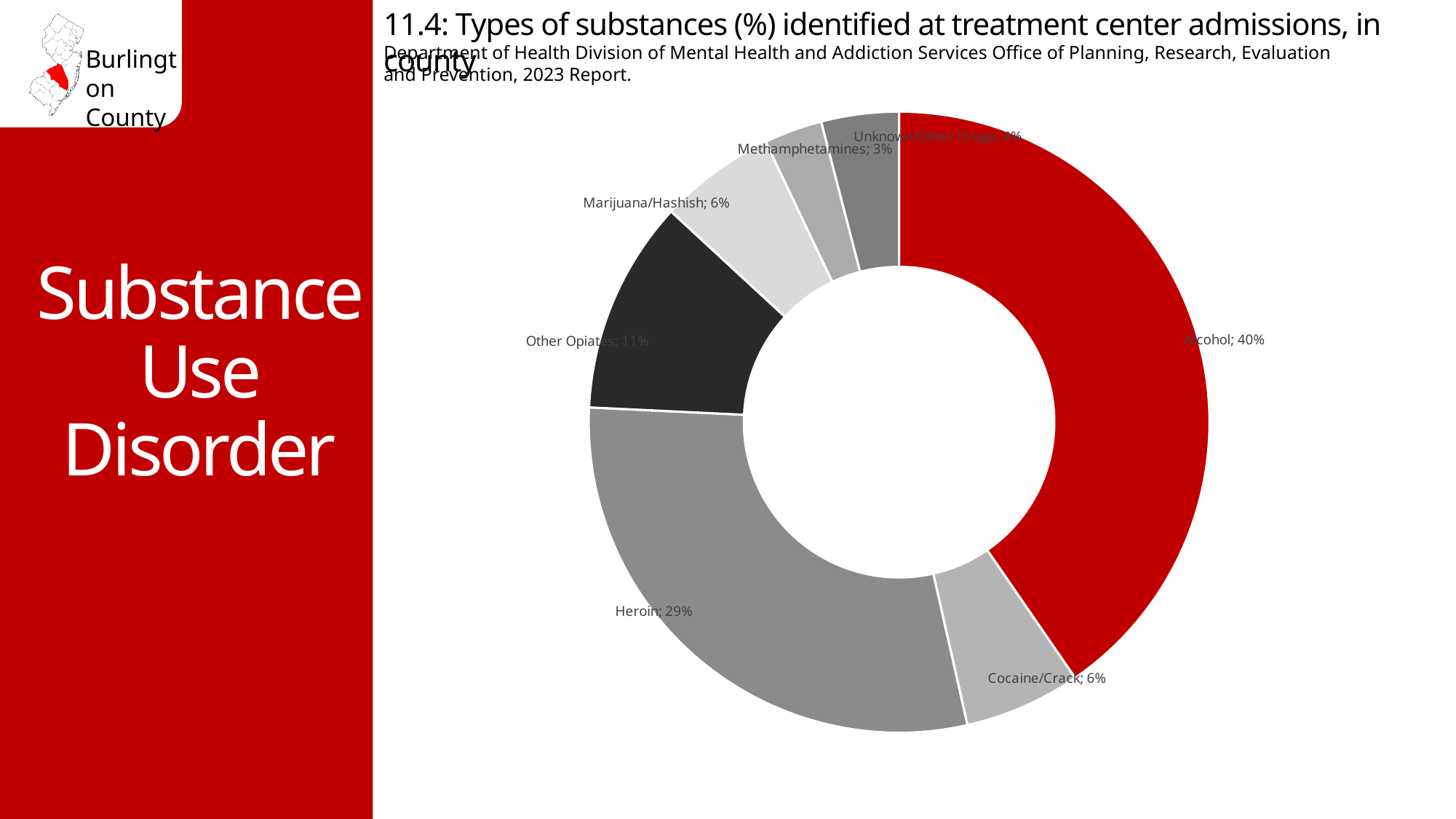
What is the value for Methamphetamines? 3% How many substance categories are shown in the chart? 7 What type of chart is used on this slide? Doughnut (pie) chart What colour is the Alcohol slice? Red What is the value for Other Opiates? 11% What percentage of treatment center admissions is attributed to Alcohol? 40% How many percentage points higher is Alcohol than Heroin? 11 What percentage is shown for Cocaine/Crack? 6% Which substance has the largest share of admissions? Alcohol What percentage is shown for Heroin? 29% Which is larger, the share for Heroin or the share for Other Opiates? Heroin Which substance has the smallest share of admissions? Methamphetamines